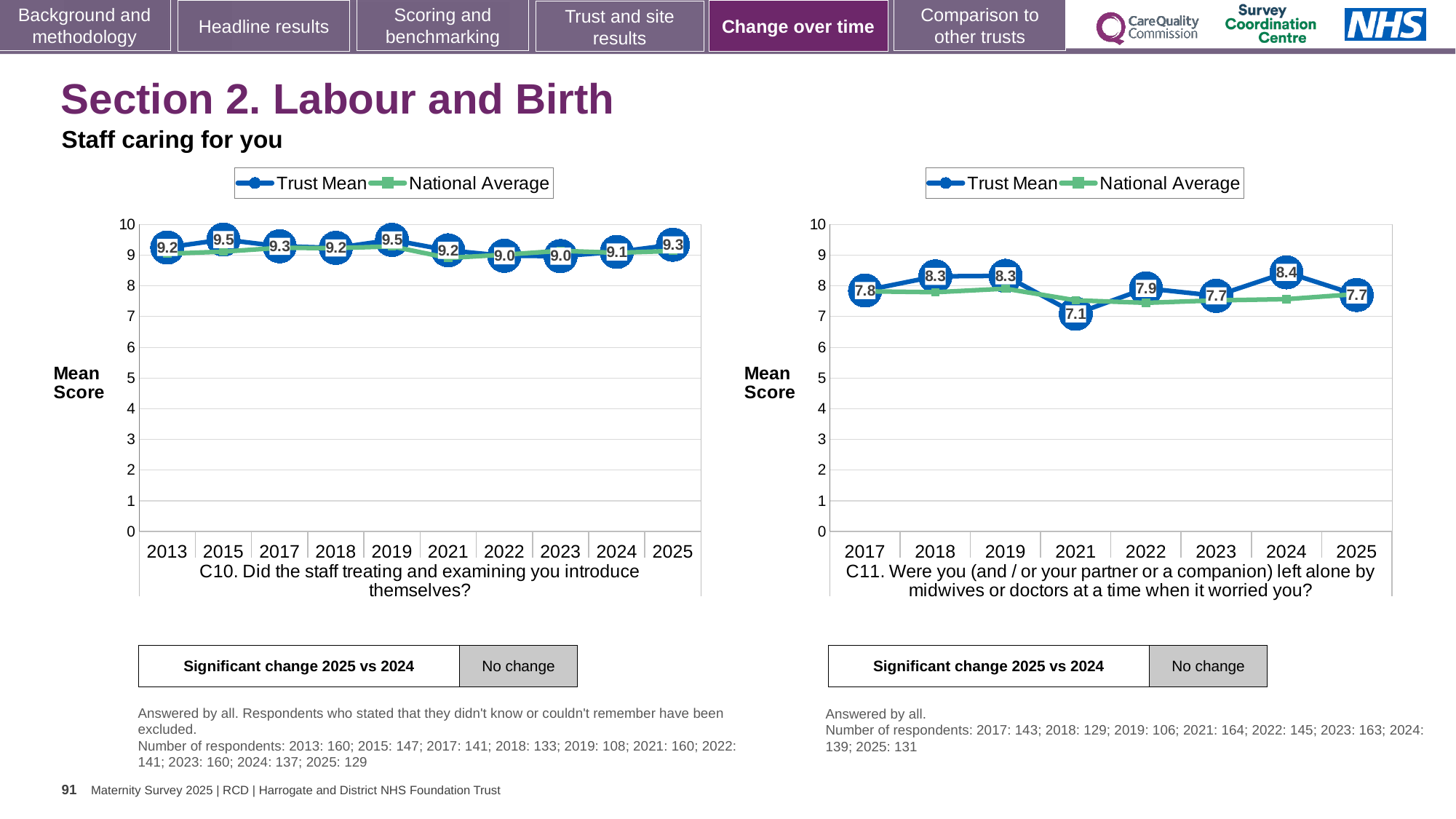
In the C11 chart on the right, how many series does the legend list? 2 In the C10 chart on the left, which year has the lowest Trust Mean? 2022 and 2023 (9.0) In the C10 chart on the left, what is the difference between the Trust Mean in 2019 and in 2022? 0.5 In the C11 chart on the right, which year has the lowest Trust Mean? 2021 In the C11 chart on the right, is the Trust Mean for 2024 larger or smaller than for 2025? larger In the C11 chart on the right, which year has the highest Trust Mean? 2024 In the C11 chart on the right, what is the Trust Mean for 2021? 7.1 In the C10 chart on the left, what is the Trust Mean for 2025? 9.3 In the C10 chart on the left, how many years are shown on the x axis? 10 In the C11 chart on the right, is the National Average for 2021 greater or less than 8? less In the C10 chart on the left, what is the Trust Mean for 2013? 9.2 What type of chart is the C11 chart on the right? line chart